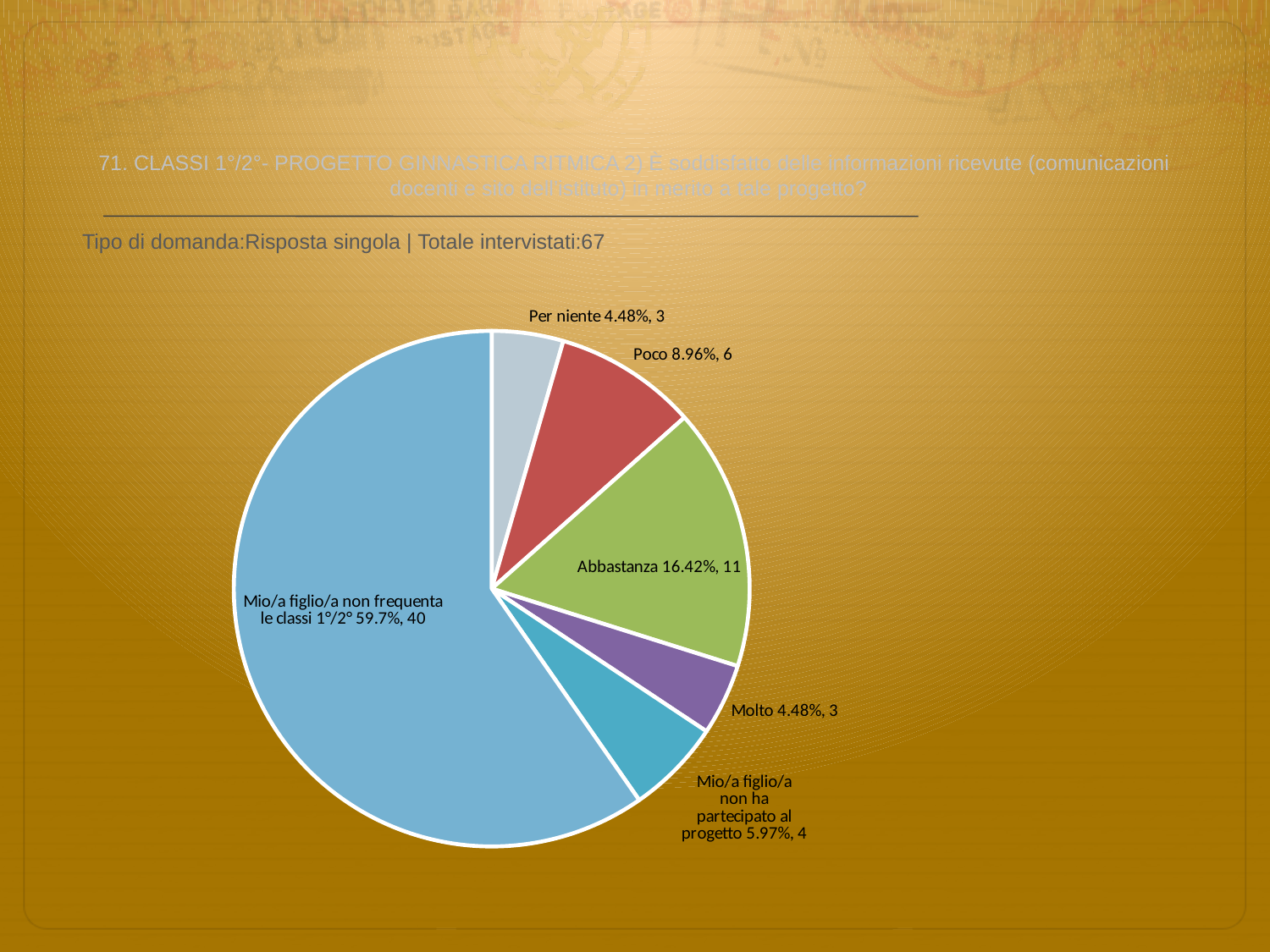
How many more respondents answered "Abbastanza" than "Poco"? 5 How many respondents answered "Molto"? 3 Which category has the largest slice of the pie? Mio/a figlio/a non frequenta le classi 1°/2° What percentage of the pie does the "Abbastanza" slice represent? 16.42% What percentage is shown for "Mio/a figlio/a non ha partecipato al progetto"? 5.97% What kind of chart is shown on the slide? pie chart Which slice is larger, "Poco" or "Abbastanza"? Abbastanza How many slices does the pie chart have? 6 What is the total number of respondents across all slices of the pie? 67 How many respondents answered "Poco"? 6 According to the text above the chart, what is the total number of interviewees (Totale intervistati)? 67 What percentage is shown for the largest slice, "Mio/a figlio/a non frequenta le classi 1°/2°"? 59.7%